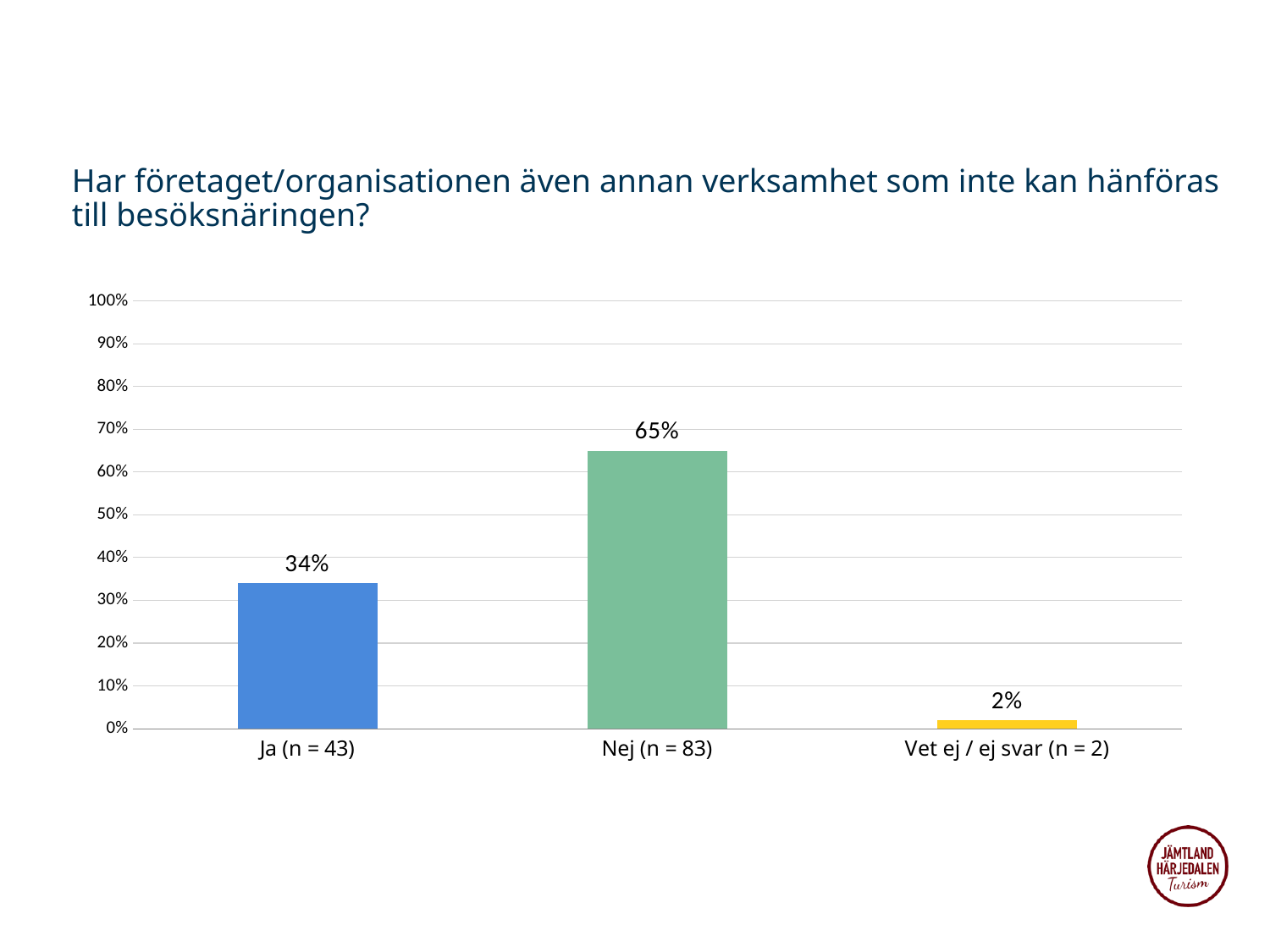
Which is larger, the value for Ja (n = 43) or the value for Nej (n = 83)? Nej (n = 83) How many categories are shown on the x axis? 3 Which category has the highest value? Nej (n = 83) Is the value for Nej (n = 83) greater or less than 50%? greater What colour is the bar for Nej (n = 83)? green What is the value for Vet ej / ej svar (n = 2)? 2% What is the value for Ja (n = 43)? 34% Which category has the lowest value? Vet ej / ej svar (n = 2) What is the value for Nej (n = 83)? 65% What is the highest value shown on the y axis? 100% What kind of chart is shown on the slide? bar chart What is the difference between the values for Nej (n = 83) and Ja (n = 43)? 31%